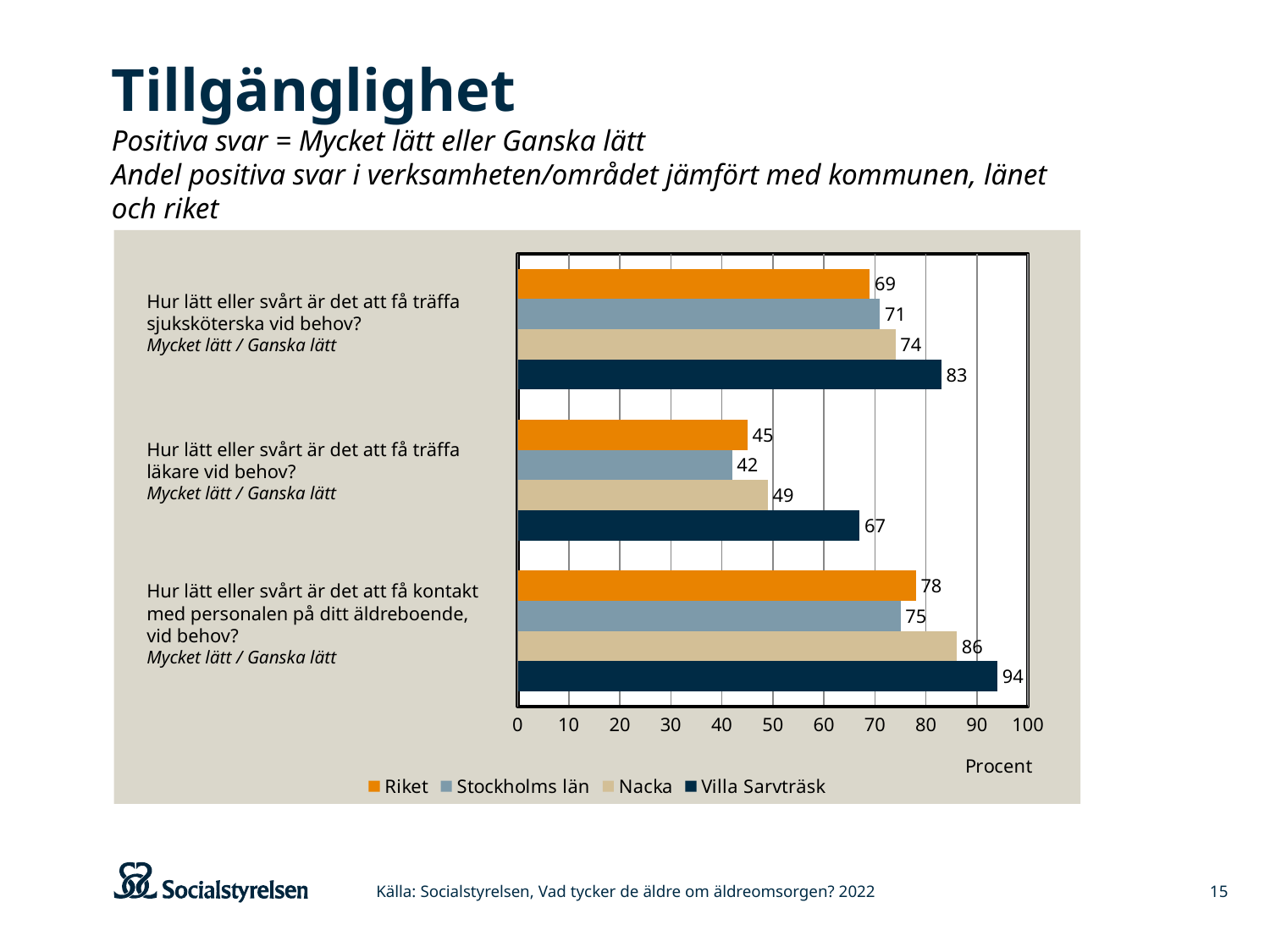
What is the difference between Villa Sarvträsk and Riket on the question about meeting a doctor when needed? 22 What unit is shown on the horizontal axis of the chart? Procent Is the value for Villa Sarvträsk on the question about meeting a doctor when needed greater or less than 60? greater What is the value for Riket on the question about meeting a doctor when needed (träffa läkare vid behov)? 45 What kind of chart is shown on the slide? Bar chart Which series has the highest value on the question about getting in contact with staff at the care home? Villa Sarvträsk Which is larger on the question about meeting a nurse when needed: Stockholms län or Nacka? Nacka How many series does the legend list? 4 What is the value for Villa Sarvträsk on the question about meeting a nurse when needed (träffa sjuksköterska vid behov)? 83 How many questions (categories) are shown in the chart? 3 What is the value for Nacka on the question about getting in contact with staff at the care home (kontakt med personalen)? 86 Which series has the lowest value on the question about meeting a doctor when needed? Stockholms län